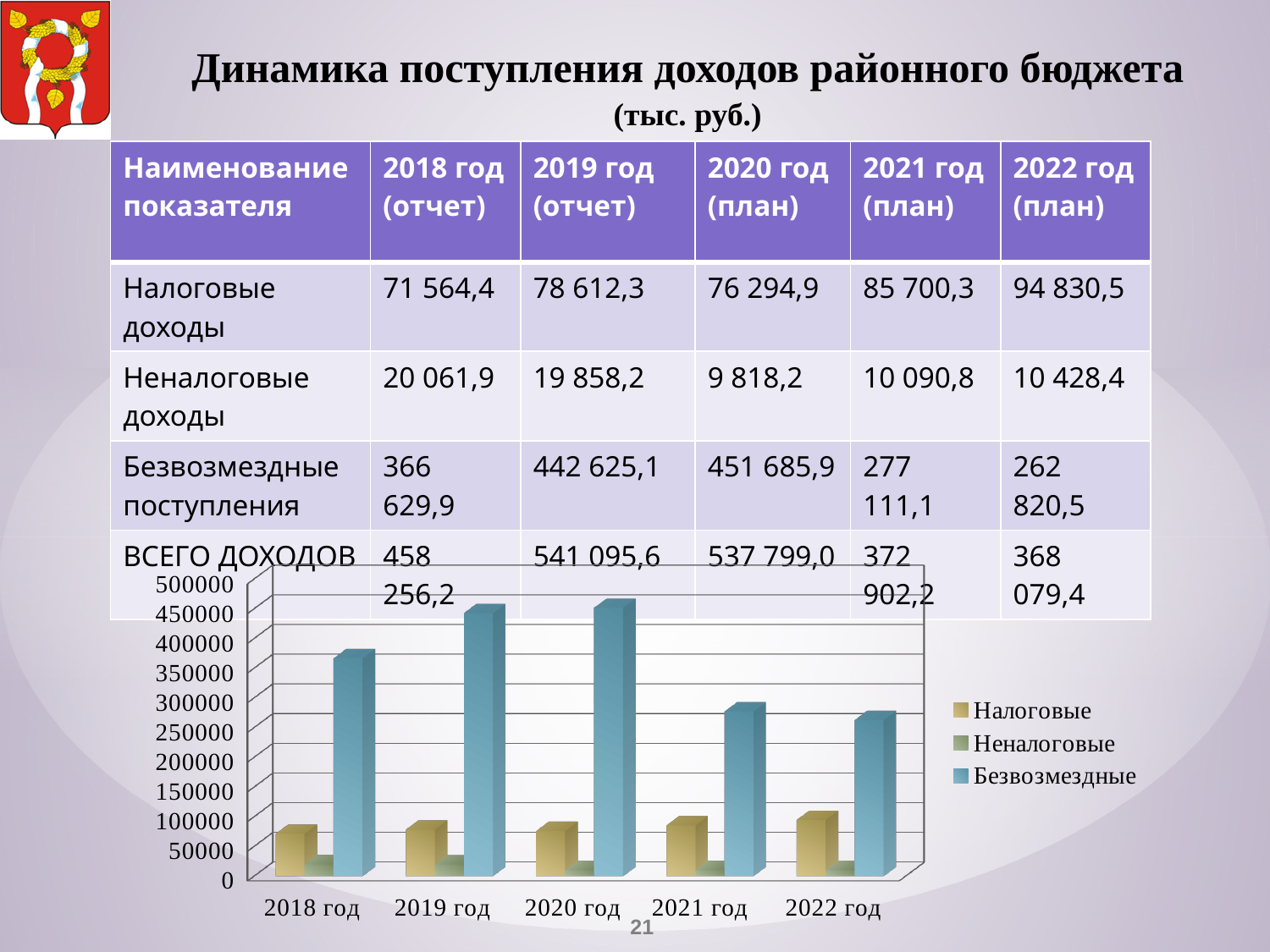
Is the value for Налоговые in 2018 год greater or less than 100000? less Is the value for Безвозмездные in 2021 год greater or less than 300000? less Do the Безвозмездные values rise or fall from 2020 год to 2022 год? fall What kind of chart is shown on the slide? bar chart Is the value for Неналоговые in 2018 год greater or less than 50000? less How many series does the chart legend list? 3 Which series is shown in blue in the chart? Безвозмездные Which is larger in the chart: Безвозмездные in 2019 год or Безвозмездные in 2021 год? 2019 год How many year categories are shown on the x axis of the chart? 5 Which series has the tallest bars in every year of the chart? Безвозмездные According to the table, what is the value of Налоговые доходы for 2022 год (план)? 94 830,5